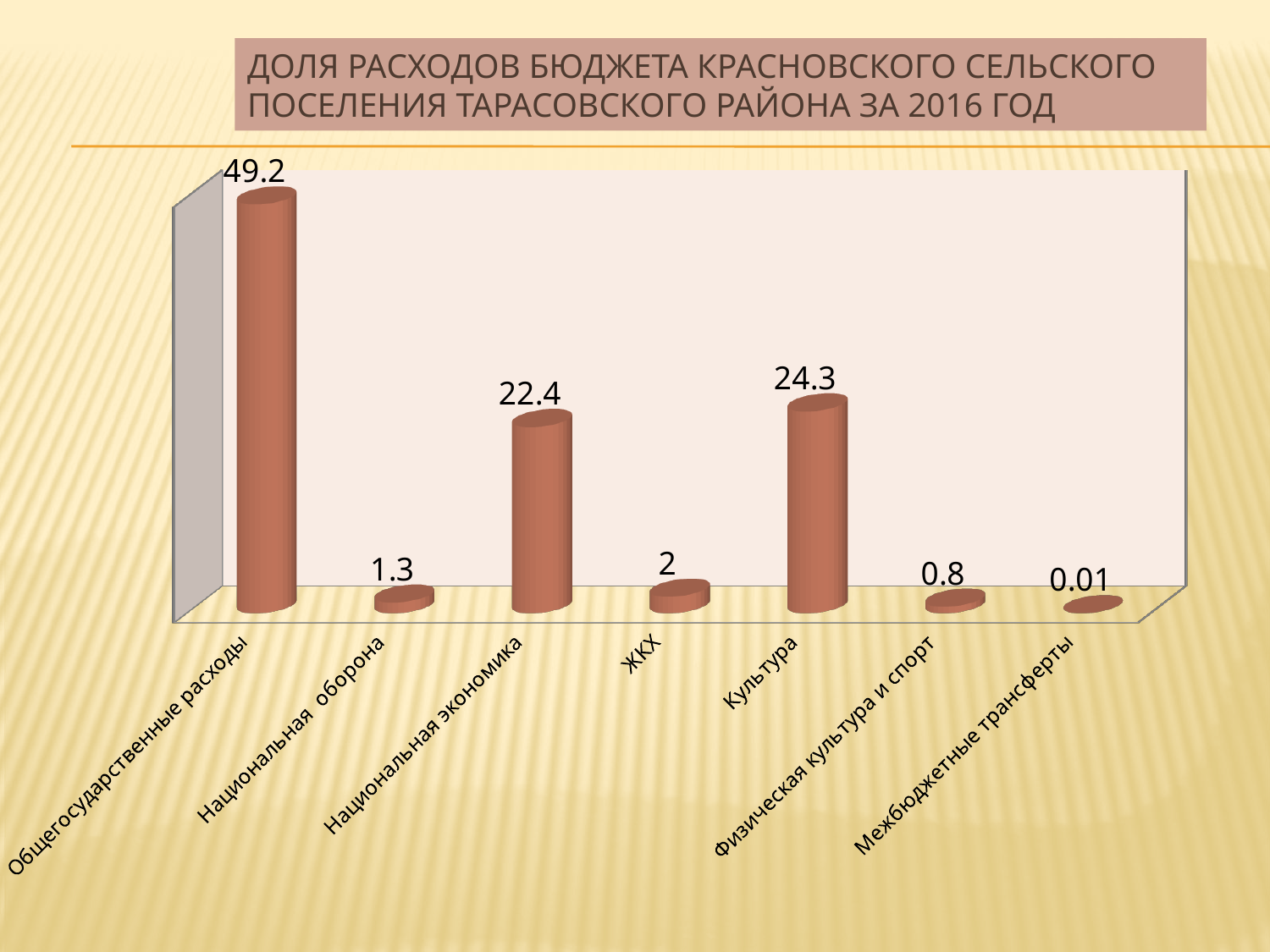
What is the value for Национальная экономика? 22.4 What is the value for Общегосударственные расходы? 49.2 Which year does the chart title refer to? 2016 Which category has the lowest value? Межбюджетные трансферты What is the value for ЖКХ? 2 What kind of chart is shown on the slide? Bar chart Which category has the highest value? Общегосударственные расходы What is the difference between the values for Культура and Национальная экономика? 1.9 What is the value for Культура? 24.3 How many categories are shown on the chart? 7 Which is larger, the value for Национальная оборона or the value for ЖКХ? ЖКХ What is the value for Межбюджетные трансферты? 0.01